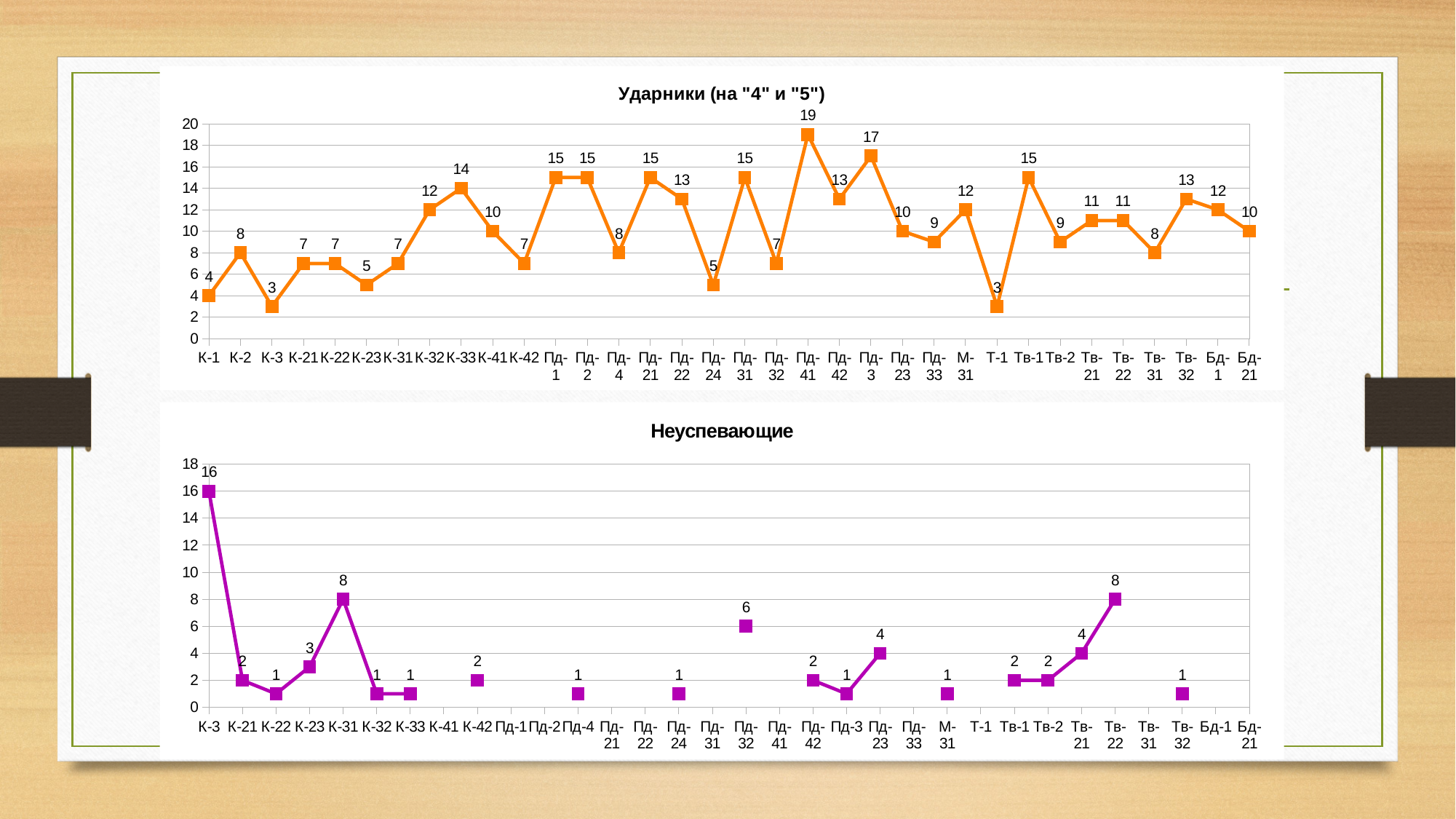
In the chart titled "Ударники (на "4" и "5")", which is larger, the value for К-32 or the value for Тв-2? К-32 In the chart titled "Ударники (на "4" и "5")", what is the difference between the values for Пд-3 and Пд-23? 7 In the chart titled "Ударники (на "4" и "5")", what is the value for Пд-41? 19 In the chart titled "Ударники (на "4" и "5")", what is the value for К-33? 14 In the chart titled "Неуспевающие", what is the value for К-3? 16 In the chart titled "Неуспевающие", which is larger, the value for К-31 or the value for К-23? К-31 In the chart titled "Неуспевающие", what is the value for Пд-32? 6 In the chart titled "Неуспевающие", what is the difference between the values for Тв-22 and Тв-21? 4 In the chart titled "Неуспевающие", which category has the highest value? К-3 In the chart titled "Ударники (на "4" и "5")", which category has the highest value? Пд-41 What kind of chart is the chart titled "Ударники (на "4" и "5")"? Line chart What is the title of the bottom chart on the slide? Неуспевающие